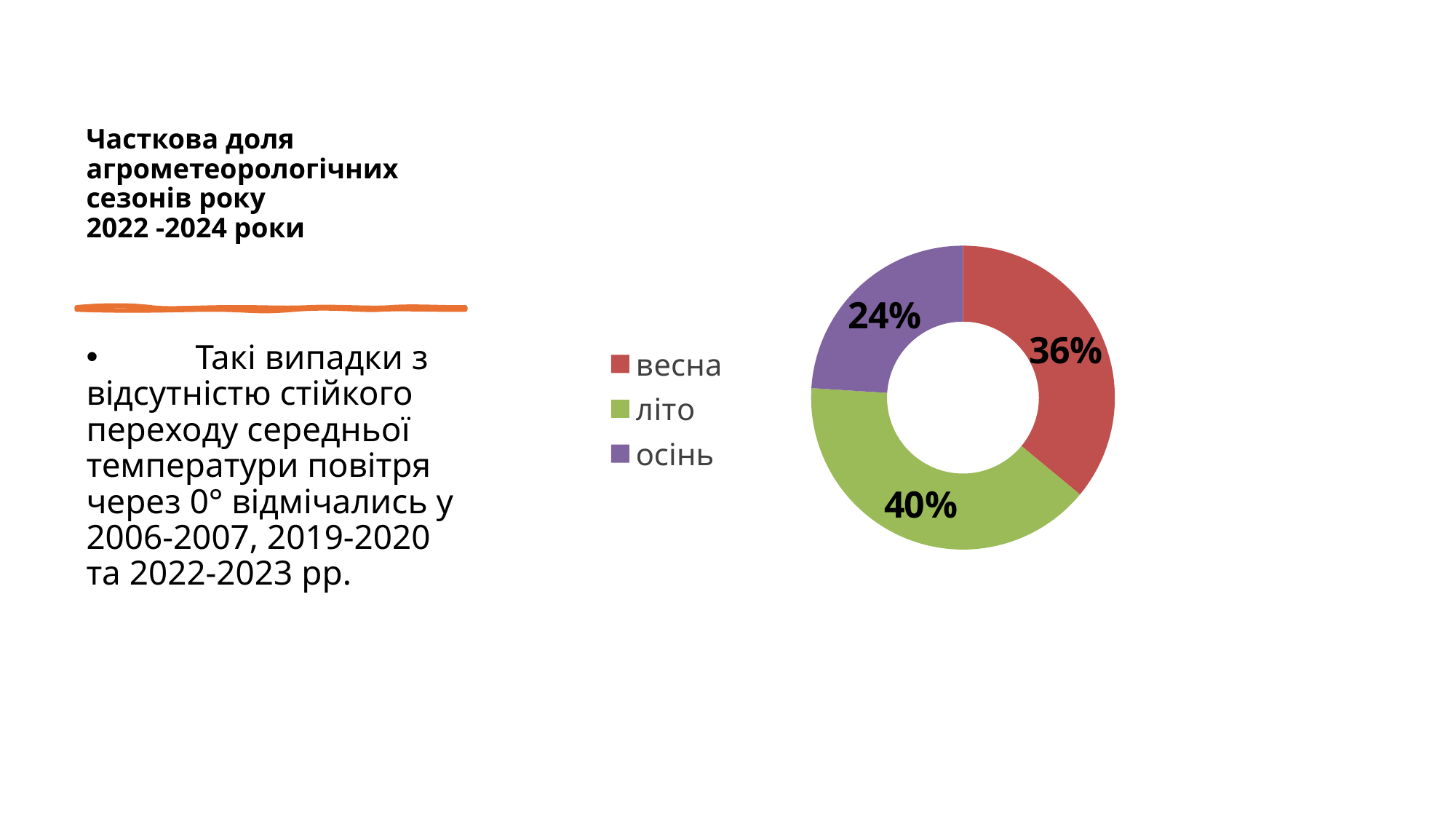
Which season has the largest share in the chart? літо How many seasons (slices) are shown in the chart? 3 What colour represents осінь in the chart? purple What share of the doughnut chart does осінь (autumn) account for? 24% What share of the doughnut chart does весна (spring) account for? 36% What share of the doughnut chart does літо (summer) account for? 40% What is the difference in percentage points between the shares of літо and осінь? 16% What type of chart is shown on the slide? doughnut (pie) chart Which season is shown in green in the chart? літо What is the difference in percentage points between the shares of весна and осінь? 12% Which season has the smallest share in the chart? осінь Which has a larger share, весна or літо? літо